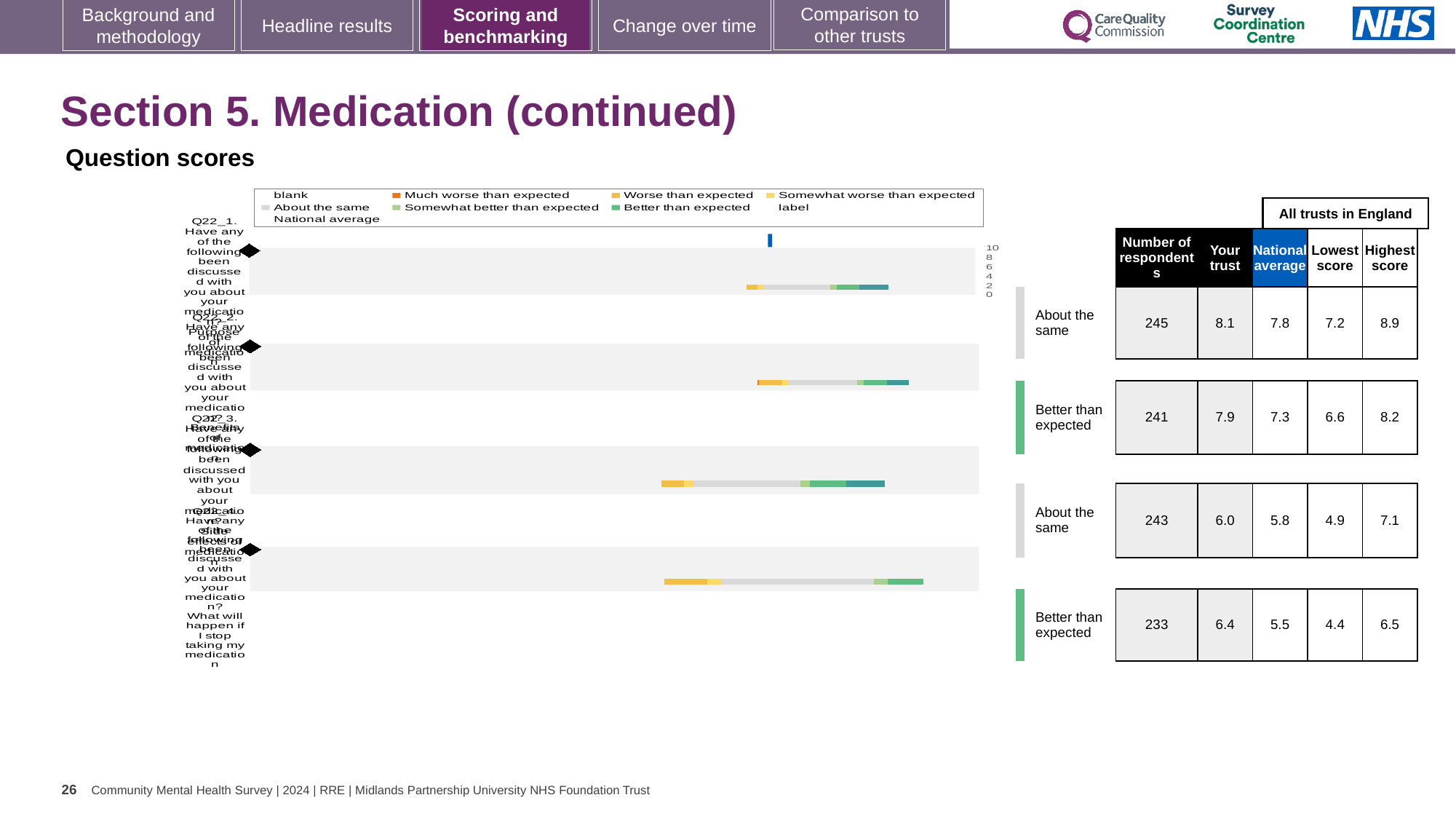
How many question bars (rows) does the chart show? 4 In the table beside the chart, which is larger for the fourth row (Q22_4): 'Your trust' or 'National average'? Your trust In the table beside the chart, which row has the lowest number of respondents? the fourth row (Q22_4), 233 In the table beside the chart, what is the national average for the third row (Q22_3)? 5.8 What is the maximum value shown on the chart's score axis? 10 Which legend entry is shown in orange? Much worse than expected In the table beside the chart, what is the 'Your trust' score for the second row (Q22_2)? 7.9 How many entries does the chart legend list? 9 In the table beside the chart, what is the highest score for the first row (Q22_1)? 8.9 In the table beside the chart, what is the number of respondents for the first row (Q22_1)? 245 What kind of chart is shown under 'Question scores'? bar chart In the table beside the chart, what is the difference between 'Your trust' and 'National average' for the first row (Q22_1)? 0.3